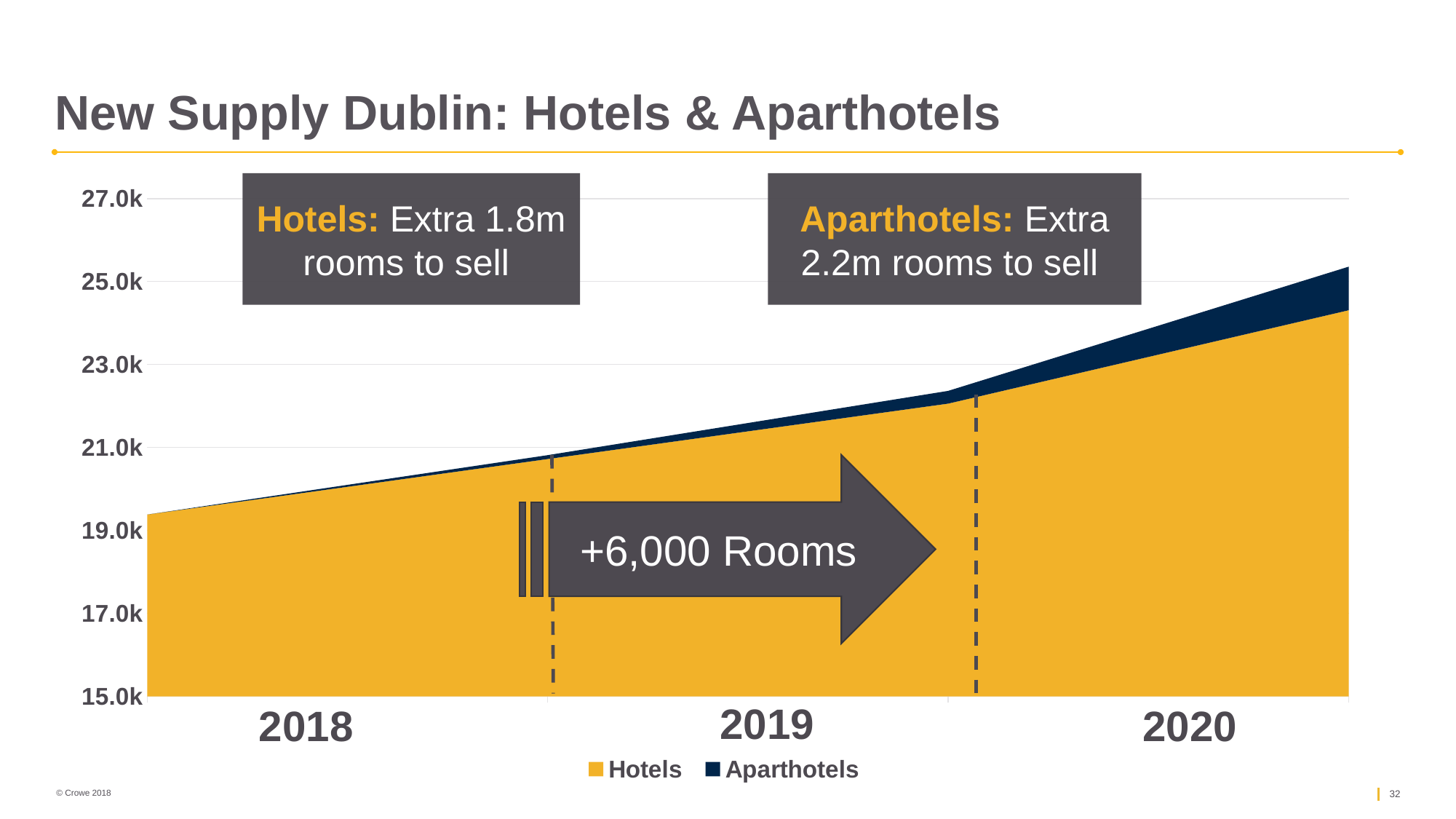
Which series occupies the larger area of the chart, Hotels or Aparthotels? Hotels What is the lowest value shown on the y axis? 15.0k Do the values rise or fall from 2018 to 2020? Rise How many years are labelled on the x axis? 3 How many series does the legend list? 2 Is the total supply at the start of 2018 greater or less than 19.0k? greater What kind of chart is shown on the slide? Stacked area chart Is the total supply at the start of 2018 greater or less than 21.0k? less Is the Hotels value in the middle of 2019 greater or less than 21.0k? greater What is the title of the chart? New Supply Dublin: Hotels & Aparthotels How many additional rooms does the arrow annotation on the chart indicate? +6,000 Rooms